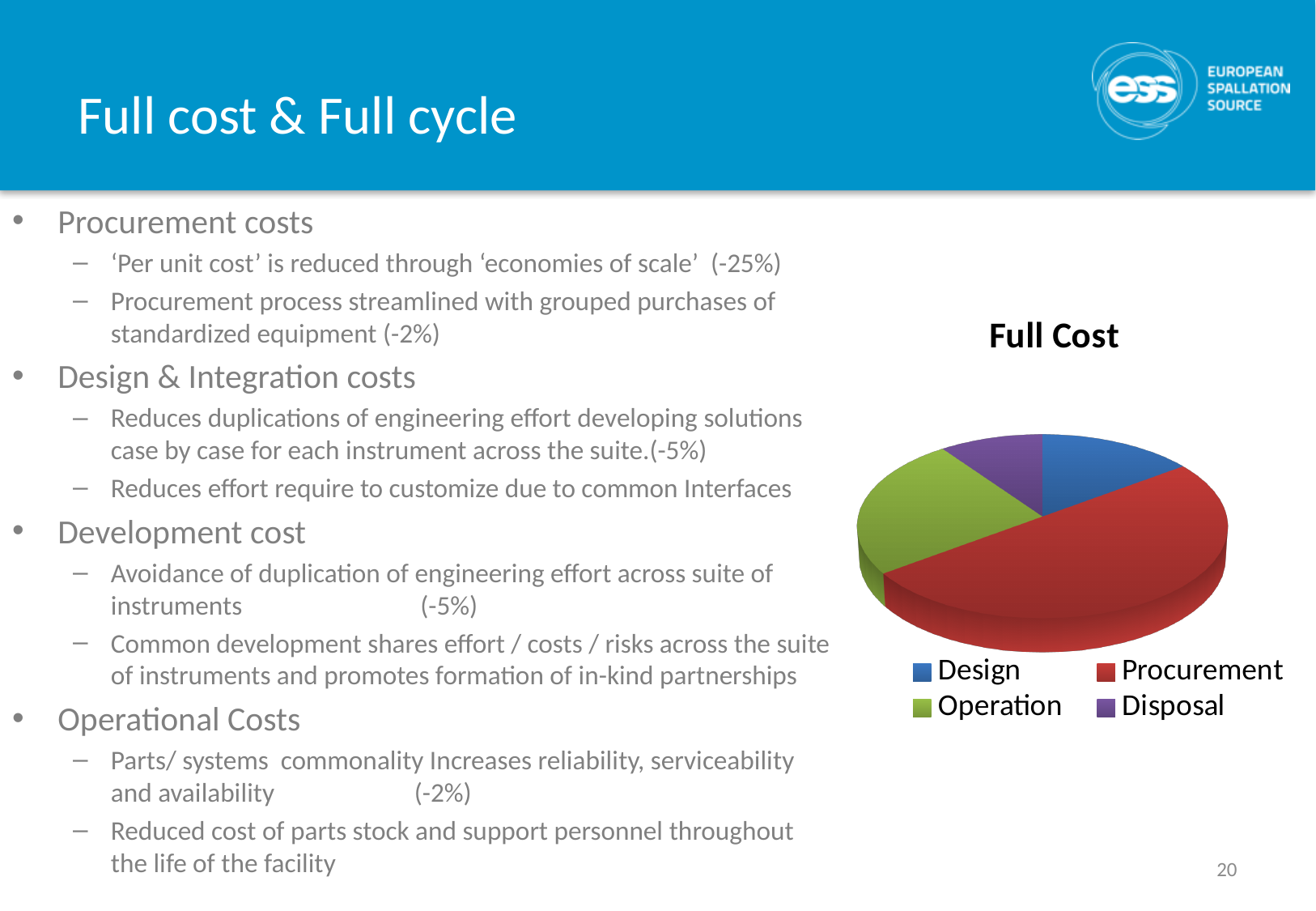
How many entries does the legend of the Full Cost chart list? 4 What colour represents Procurement in the Full Cost pie chart? Red In the Full Cost pie chart, which slice is larger, Operation or Design? Operation How many slices does the Full Cost pie chart have? 4 In the Full Cost pie chart, which slice is larger, Procurement or Disposal? Procurement In the Full Cost pie chart, which slice is larger, Procurement or Operation? Procurement Which category has the largest slice in the Full Cost pie chart? Procurement What is the title of the chart? Full Cost Which category in the Full Cost pie chart is shown in green? Operation What kind of chart is shown on the slide? Pie chart